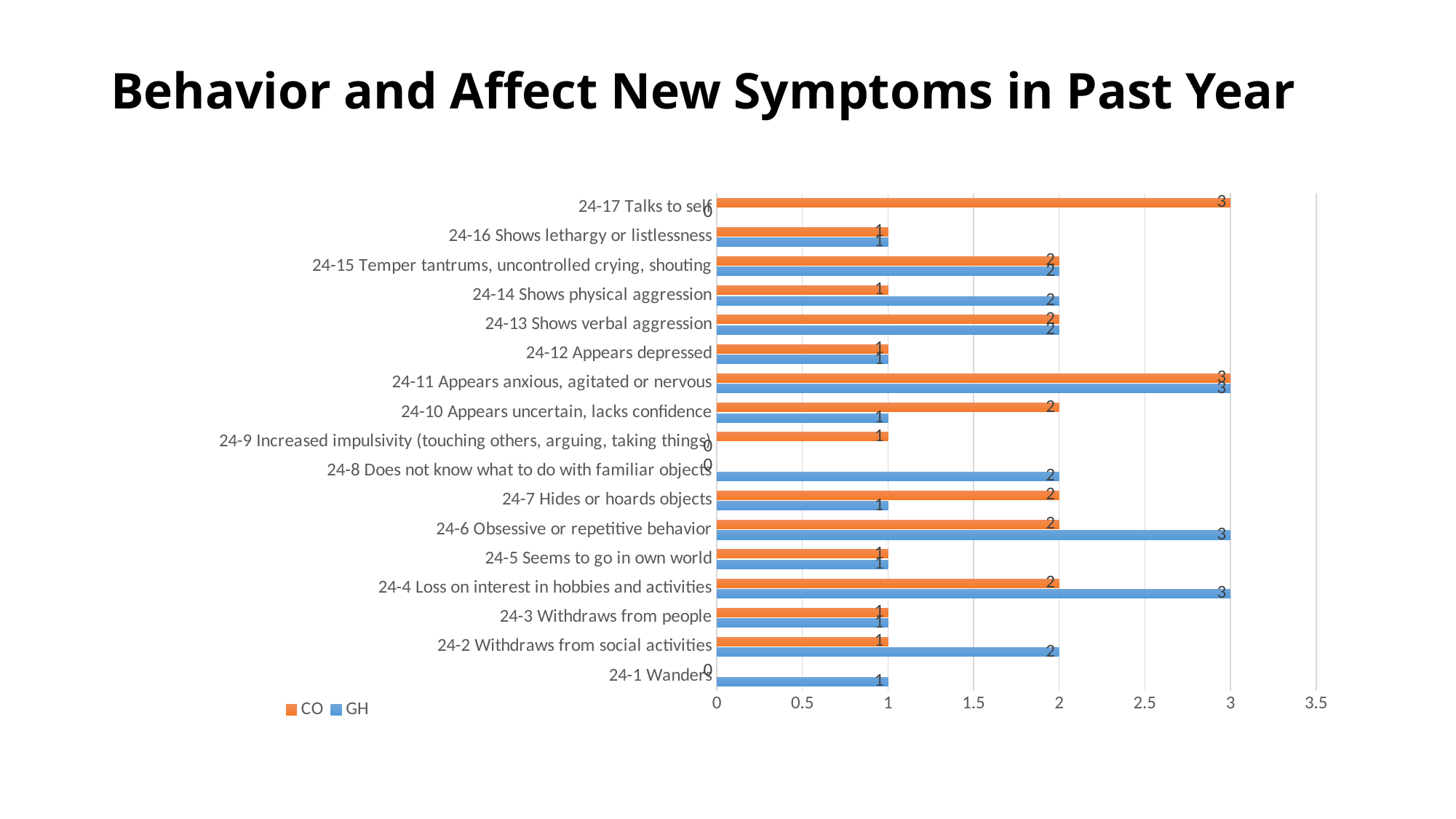
What type of chart is shown on the slide? bar chart What is the difference between the GH and CO values for 24-4 Loss on interest in hobbies and activities? 1 What is the CO value for 24-1 Wanders? 0 What is the GH value for 24-6 Obsessive or repetitive behavior? 3 For 24-14 Shows physical aggression, which series has the larger value, CO or GH? GH For 24-10 Appears uncertain, lacks confidence, which series has the larger value, CO or GH? CO Which series is shown in orange in the legend? CO What is the difference between the CO and GH values for 24-17 Talks to self? 3 How many series does the legend list? 2 How many categories (symptoms) are plotted on the chart? 17 What is the CO value for 24-17 Talks to self? 3 What is the GH value for 24-8 Does not know what to do with familiar objects? 2